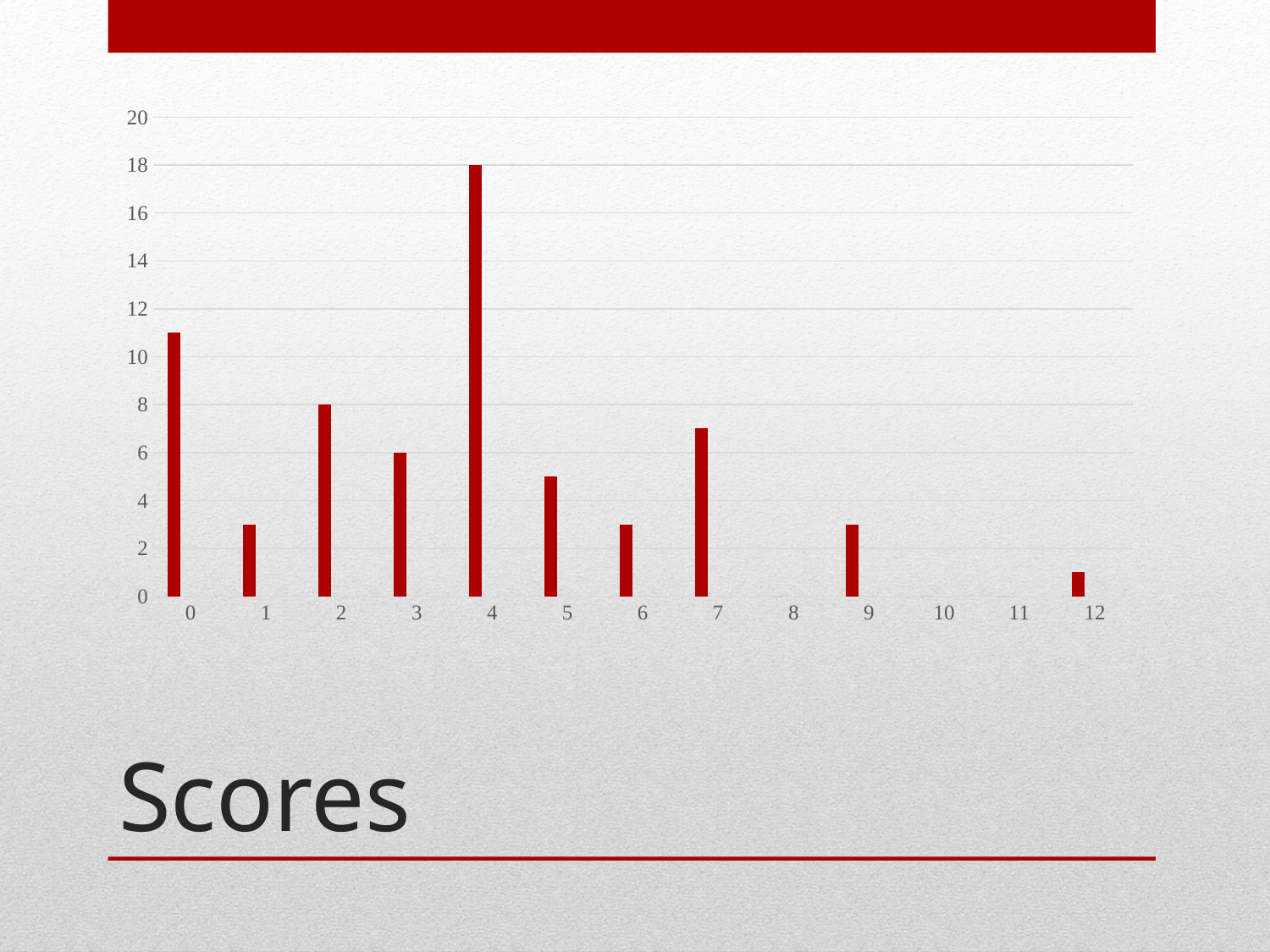
What is the value for category 3? 6 What is the value for category 2? 8 What kind of chart is shown on the slide? bar chart Which has the larger value, category 0 or category 4? 4 Is the value for category 0 greater or less than 10? greater What is the difference between the values for category 4 and category 2? 10 Which category has the highest bar? 4 What is the value for category 4? 18 What is the title text shown below the chart on the slide? Scores Is the value for category 12 greater or less than 2? less How many categories are shown along the x axis? 13 Is the value for category 1 greater or less than 4? less